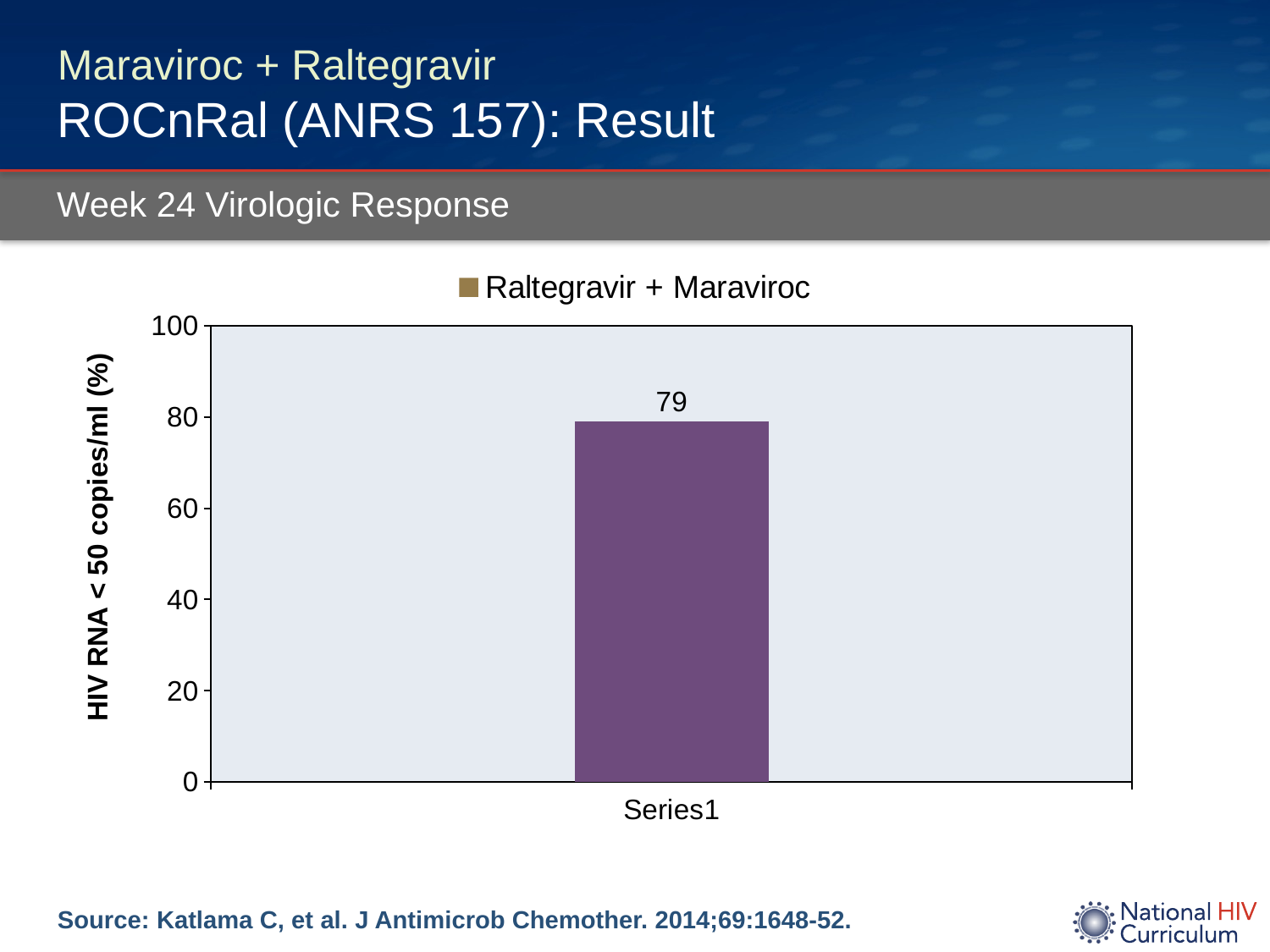
How many series does the legend list? 1 What is the category label shown on the x axis? Series1 What is the value of the Raltegravir + Maraviroc bar? 79 What is the maximum value shown on the y axis? 100 How many bars are plotted in the chart? 1 What kind of chart is shown on the slide? bar chart Is the value for Raltegravir + Maraviroc greater or less than 60? greater What percentage of patients had HIV RNA < 50 copies/ml at week 24? 79 What is the y-axis label of the chart? HIV RNA < 50 copies/ml (%) Is the value for Raltegravir + Maraviroc greater or less than 80? less What is the label of the series shown in the legend? Raltegravir + Maraviroc